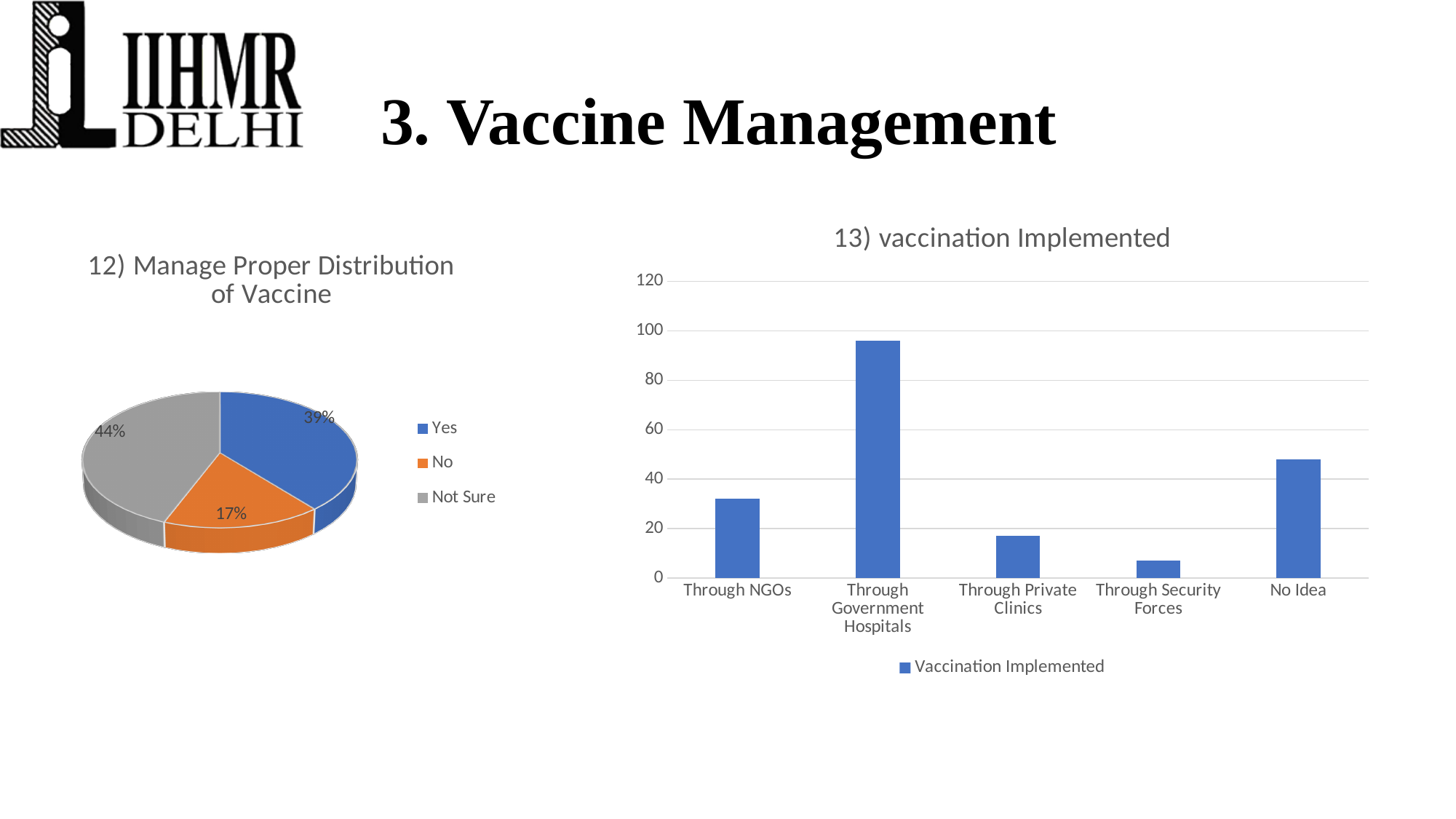
In the chart '13) vaccination Implemented', which category has the lowest value? Through Security Forces In the chart '13) vaccination Implemented', which category has the highest value? Through Government Hospitals In the pie chart '12) Manage Proper Distribution of Vaccine', which response has the smallest share? No What kind of chart is '12) Manage Proper Distribution of Vaccine'? Pie chart In the chart '13) vaccination Implemented', how many categories are shown on the x axis? 5 In the chart '13) vaccination Implemented', is the value for Through NGOs greater or less than 40? less In the pie chart '12) Manage Proper Distribution of Vaccine', how many slices does the pie have? 3 In the pie chart '12) Manage Proper Distribution of Vaccine', which response has the largest share? Not Sure In the chart '13) vaccination Implemented', which is larger: No Idea or Through Private Clinics? No Idea In the pie chart '12) Manage Proper Distribution of Vaccine', what percentage answered No? 17% In the pie chart '12) Manage Proper Distribution of Vaccine', what percentage answered Yes? 39% In the pie chart '12) Manage Proper Distribution of Vaccine', what is the difference in percentage points between Not Sure and Yes? 5